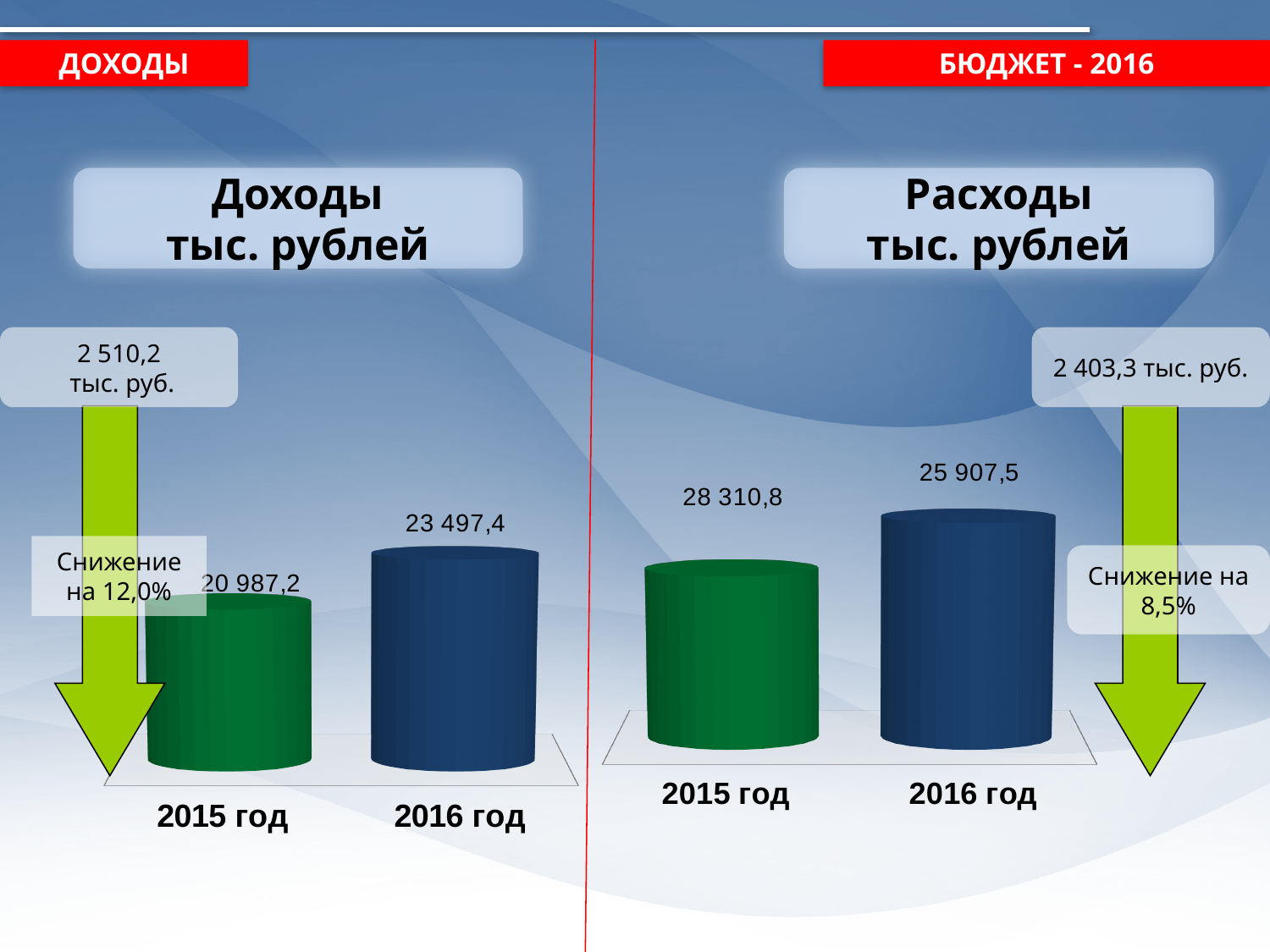
In the 'Расходы тыс. рублей' chart, what is the difference between the 2015 год and 2016 год values? 2 403,3 In the 'Расходы тыс. рублей' chart, which year has the lower value? 2016 год In the 'Доходы тыс. рублей' chart, what is the value for 2016 год? 23 497,4 How many categories are shown in the 'Доходы тыс. рублей' chart? 2 In the 'Доходы тыс. рублей' chart, which year has the higher value? 2016 год In the 'Расходы тыс. рублей' chart, do the values rise or fall from 2015 год to 2016 год? fall In the 'Доходы тыс. рублей' chart, what is the difference between the 2016 год and 2015 год values? 2 510,2 In the 'Доходы тыс. рублей' chart, what is the value for 2015 год? 20 987,2 In the 'Расходы тыс. рублей' chart, is the value for 2015 год larger or smaller than the value for 2016 год? larger In the 'Расходы тыс. рублей' chart, what is the value for 2016 год? 25 907,5 In the 'Расходы тыс. рублей' chart, what is the value for 2015 год? 28 310,8 What kind of chart is the 'Расходы тыс. рублей' chart? bar chart